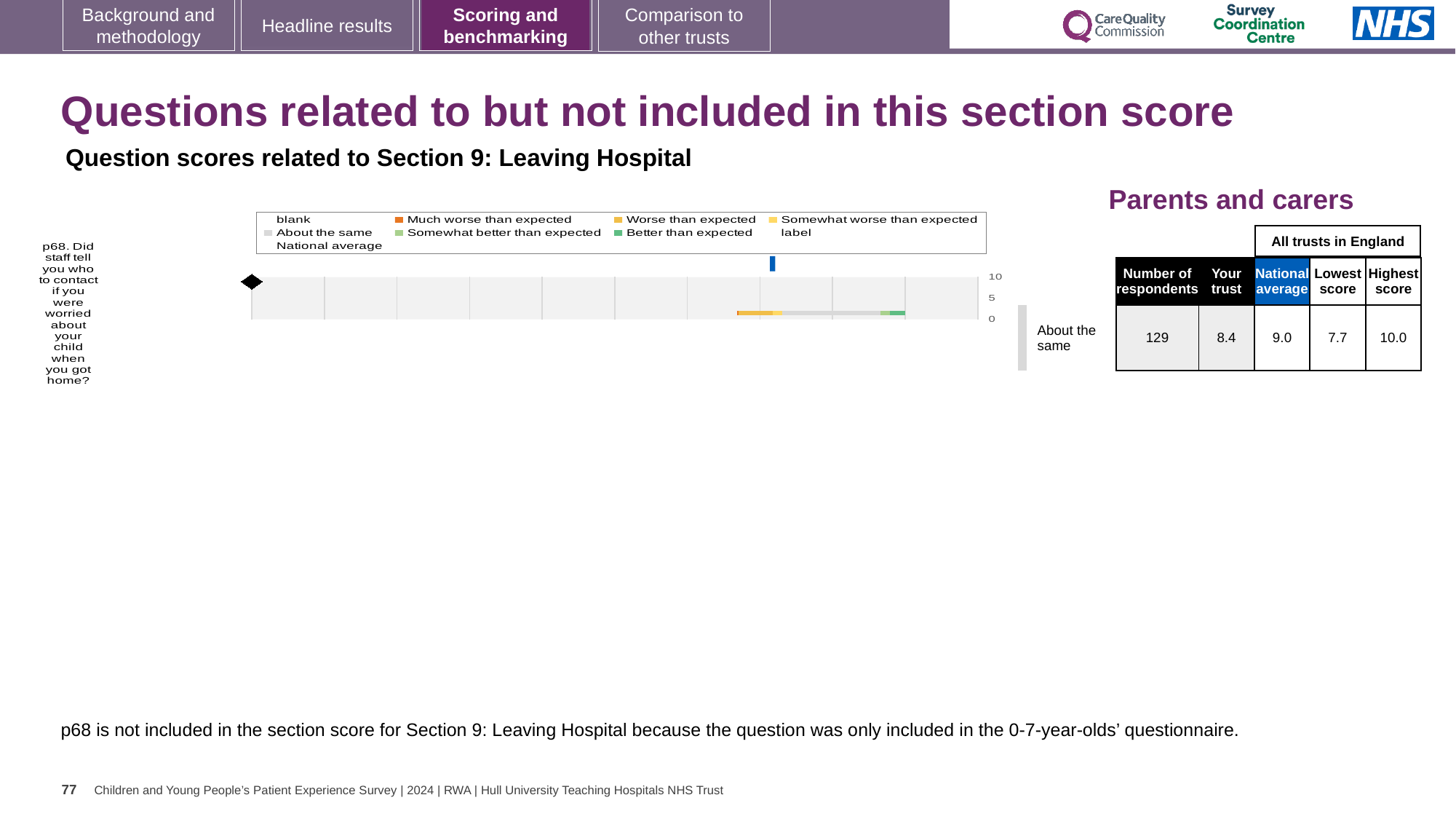
How is the trust's result for p68 categorised relative to other trusts? About the same How many questions are plotted in the chart on this slide? 1 What is the maximum value shown on the chart's score axis? 10 Which legend entry is shown in dark green in the chart? Better than expected What is the difference between the highest and lowest trust scores for p68? 2.3 What is the lowest score among all trusts in England for question p68? 7.7 What is the difference between the national average and the trust's score for p68? 0.6 Is the trust's score for p68 higher or lower than the national average? lower What is the national average score for question p68? 9.0 What is the highest score among all trusts in England for question p68? 10.0 What is the 'Your trust' score for question p68 shown on the slide? 8.4 How many respondents answered question p68? 129